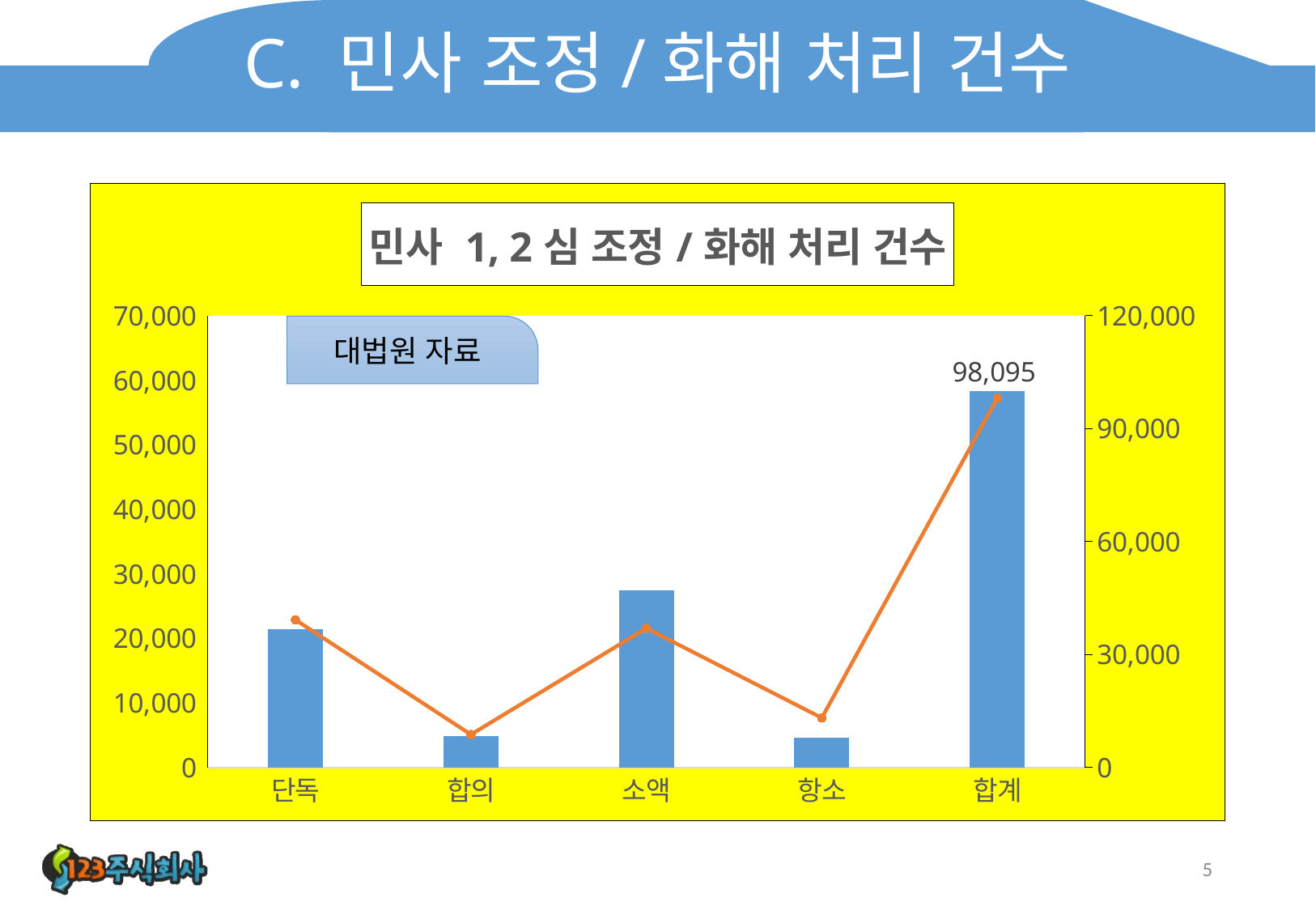
What is the title of the chart? 민사 1, 2 심 조정 / 화해 처리 건수 What kind of chart is this? bar and line chart What is the value shown by the data label on the line at 합계? 98,095 Is the bar for 소액 greater or less than 20,000 on the left axis? greater Is the bar for 합계 greater or less than 50,000 on the left axis? greater Which bar is taller, 소액 or 단독? 소액 Which category has the lowest point on the line? 합의 What data source is named in the box inside the chart? 대법원 자료 How many categories are shown on the x axis? 5 Is the bar for 합의 greater or less than 10,000 on the left axis? less Which category has the tallest bar? 합계